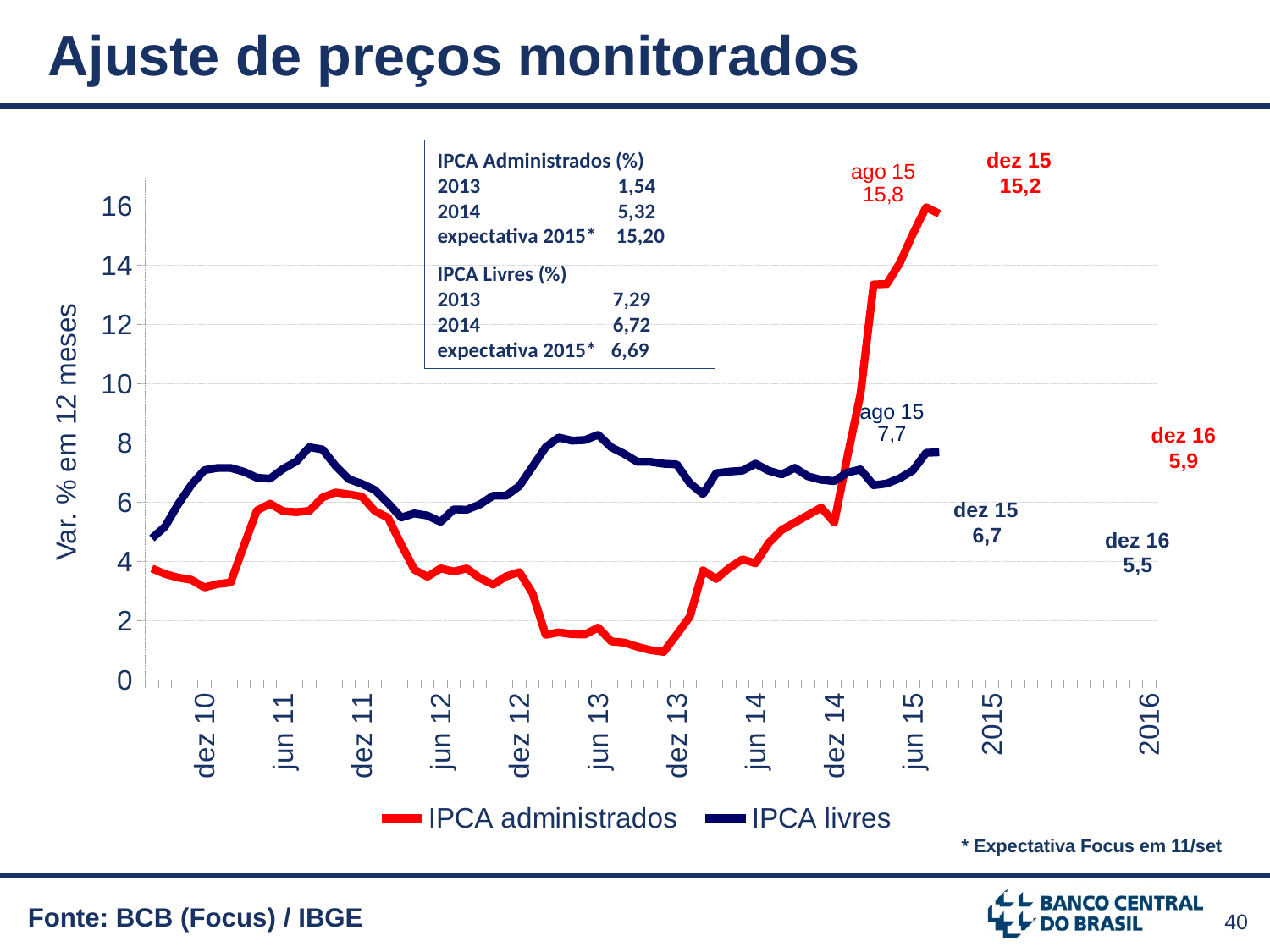
How many series does the legend list? 2 What is the labelled value of IPCA livres for dez 16? 5,5 What is the labelled value of IPCA administrados for dez 15? 15,2 What type of chart is shown on the slide? line chart What is the difference between the ago 15 values of IPCA administrados (15,8) and IPCA livres (7,7)? 8,1 Does the IPCA administrados line rise or fall between dez 13 and ago 15? rise What is the labelled value of IPCA livres for ago 15? 7,7 What is the title of the slide? Ajuste de preços monitorados What is the labelled value of IPCA administrados for ago 15? 15,8 Which series has the higher labelled value for dez 16, IPCA administrados or IPCA livres? IPCA administrados According to the inset table, what is the expectativa 2015 value for IPCA Administrados (%)? 15,20 Is the value of IPCA administrados at dez 13 greater or less than 4? less